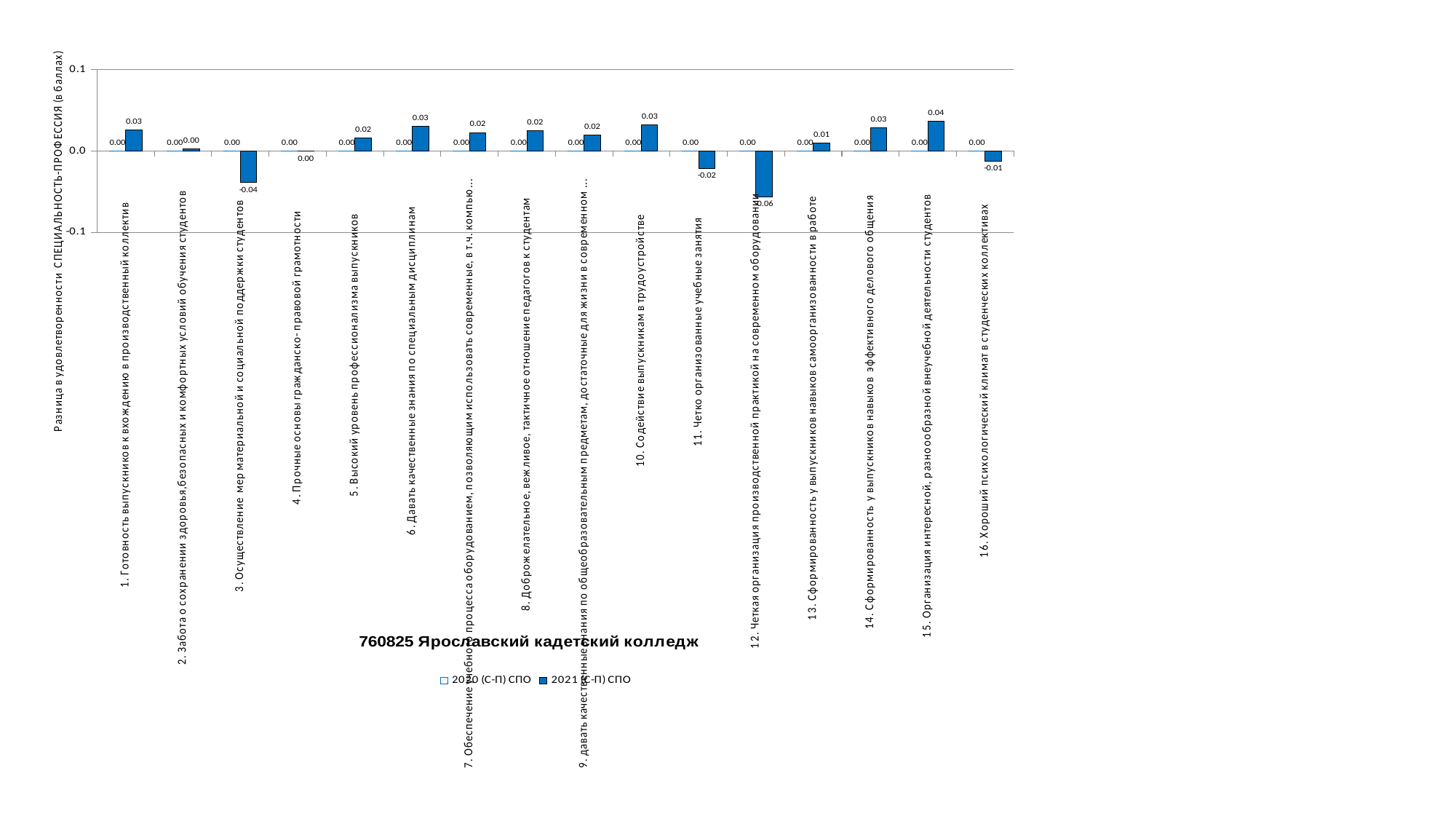
What is the 2021 (С-П) СПО value for category 3 (Осуществление мер материальной и социальной поддержки студентов)? -0.04 What is the 2020 (С-П) СПО value for category 10 (Содействие выпускникам в трудоустройстве)? 0.00 How many series does the legend list? 2 What is the 2021 (С-П) СПО value for category 13 (Сформированность у выпускников навыков самоорганизованности в работе)? 0.01 Which category has the highest 2021 (С-П) СПО value? 15. Организация интересной, разноообразной внеучебной деятельности студентов What is the title of the chart? 760825 Ярославский кадетский колледж Which category has the lowest 2021 (С-П) СПО value? 12. Четкая организация производственной практикой на современном оборудовании What type of chart is shown on the slide? bar chart Which is larger, the 2021 (С-П) СПО value for category 1 or for category 11? category 1 What is the difference between the 2021 (С-П) СПО values for category 15 and category 3? 0.08 How many categories are shown on the x axis? 16 What is the 2021 (С-П) СПО value for category 15 (Организация интересной, разноообразной внеучебной деятельности студентов)? 0.04